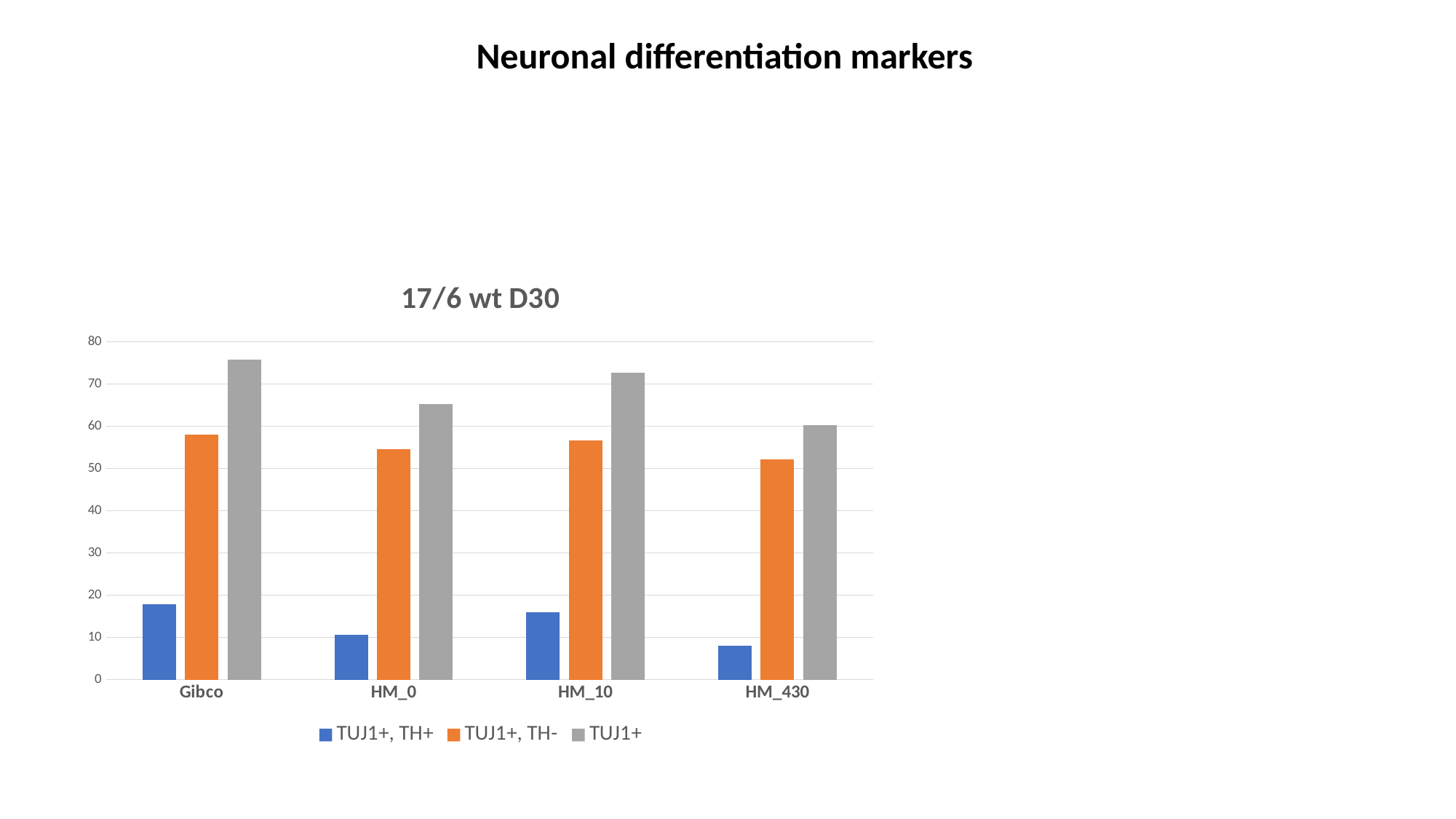
Which category has the lowest TUJ1+ value? HM_430 Is the TUJ1+, TH+ value for HM_430 greater or less than 10? less Which has the larger TUJ1+ value, HM_0 or HM_10? HM_10 How many series does the legend list? 3 What is the title of the chart? 17/6 wt D30 Which has the larger TUJ1+, TH- value, Gibco or HM_430? Gibco How many categories are shown on the x axis of the chart? 4 Which category has the lowest TUJ1+, TH+ value? HM_430 Is the TUJ1+, TH- value for HM_0 greater or less than 50? greater What kind of chart is shown on the slide? bar chart Which category has the highest TUJ1+ value? Gibco Is the TUJ1+ value for Gibco greater or less than 70? greater